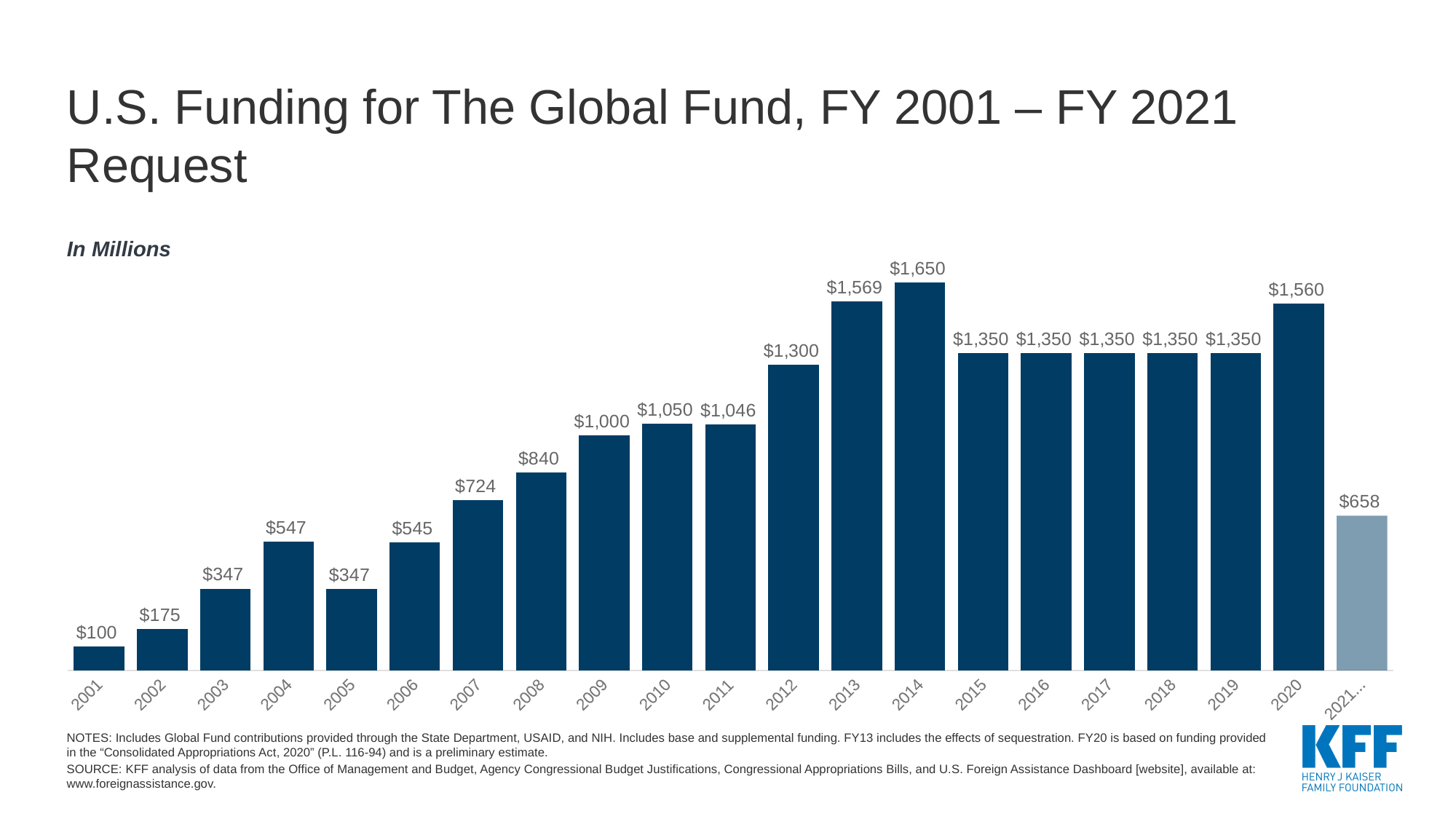
Which is larger, the value for 2010 or the value for 2011? 2010 What is the value for the 2021 request bar? $658 What unit does the chart say the values are in? In Millions What is the difference between the values for 2020 and the 2021 request? $902 What is the difference between the values for 2013 and 2012? $269 What kind of chart is shown on the slide? Bar chart What is the value for 2001? $100 How many bars are shown in the chart? 21 Do the values generally rise or fall from 2001 to 2014? Rise Which year has the highest value? 2014 Which year has the lowest value? 2001 What is the value for 2014? $1,650